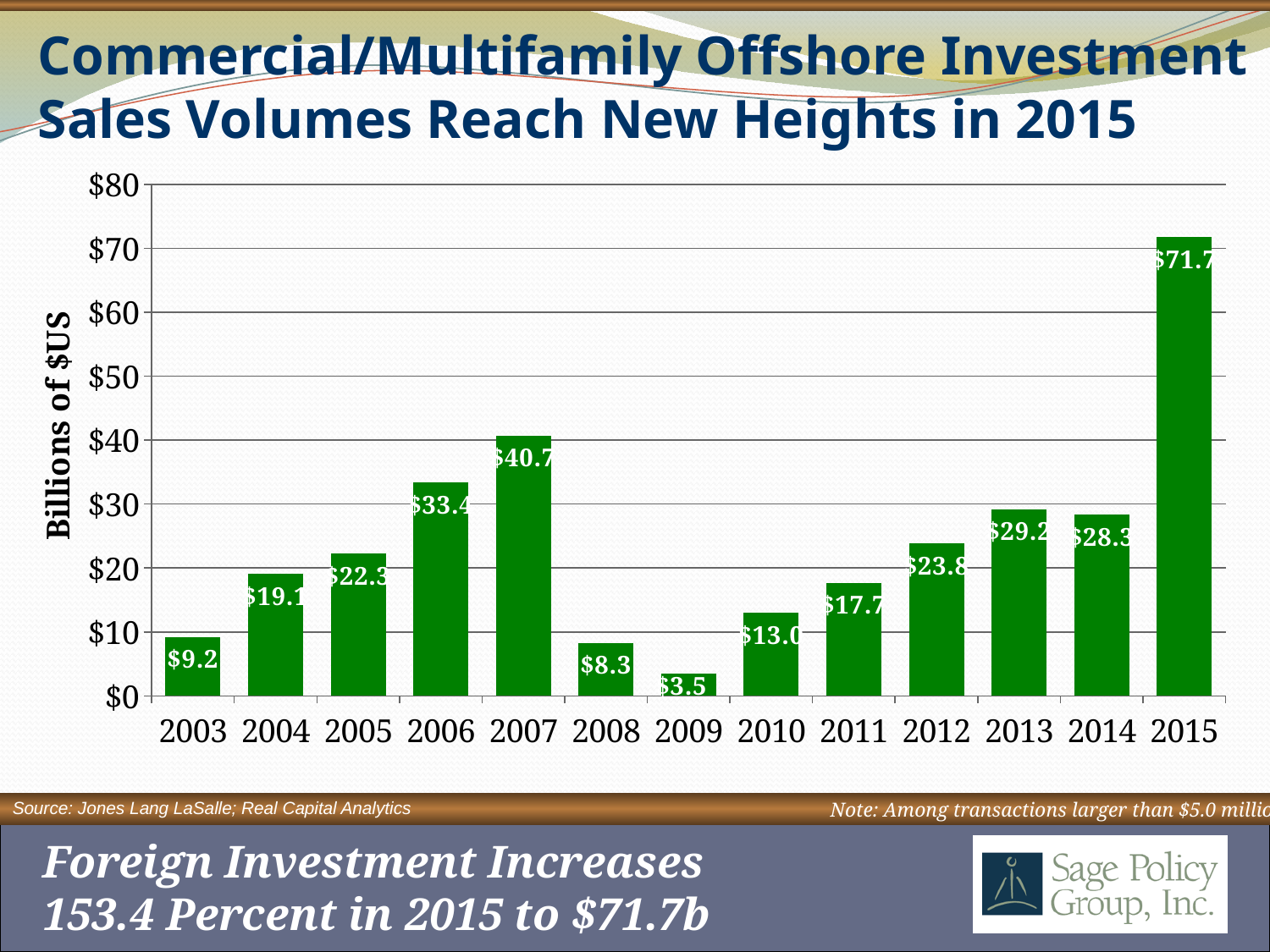
How many years are shown on the x axis? 13 Which is larger, the value for 2006 or the value for 2013? 2006 Is the value for 2012 greater or less than $20? greater What is the value for 2007? $40.7 What kind of chart is shown on the slide? Bar chart What is the value for 2009? $3.5 What is the difference between the values for 2015 and 2014? $43.4 Which year has the lowest value? 2009 Do the values rise or fall from 2009 to 2013? Rise Which year has the highest value? 2015 What is the label of the y axis? Billions of $US What is the value for 2015? $71.7